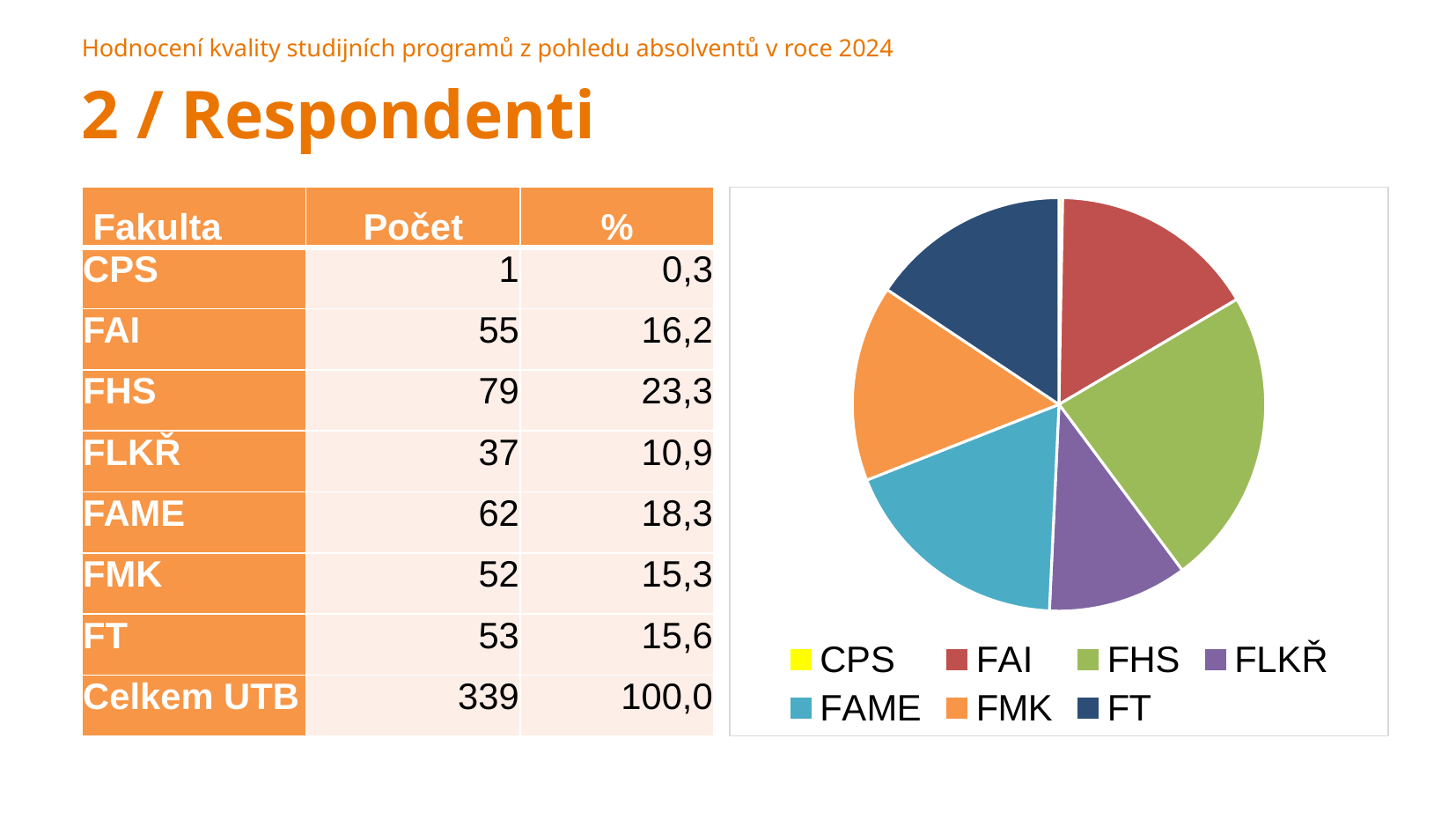
What percentage share does FLKŘ have according to the slide? 10,9 What is the count (Počet) for FAME shown on the slide? 62 What is the total number of respondents (Celkem UTB) shown on the slide? 339 What percentage share does FHS have according to the slide? 23,3 How many entries does the pie chart's legend list? 7 Which faculty is shown in dark blue in the pie chart legend? FT In the pie chart, is the slice for FLKŘ larger or smaller than the slice for FAME? smaller In the pie chart, is the slice for FHS larger or smaller than the slice for FAI? larger Which faculty has the smallest slice in the pie chart? CPS What colour is the FHS slice in the pie chart? green Which faculty has the largest slice in the pie chart? FHS What kind of chart is shown on the slide? pie chart